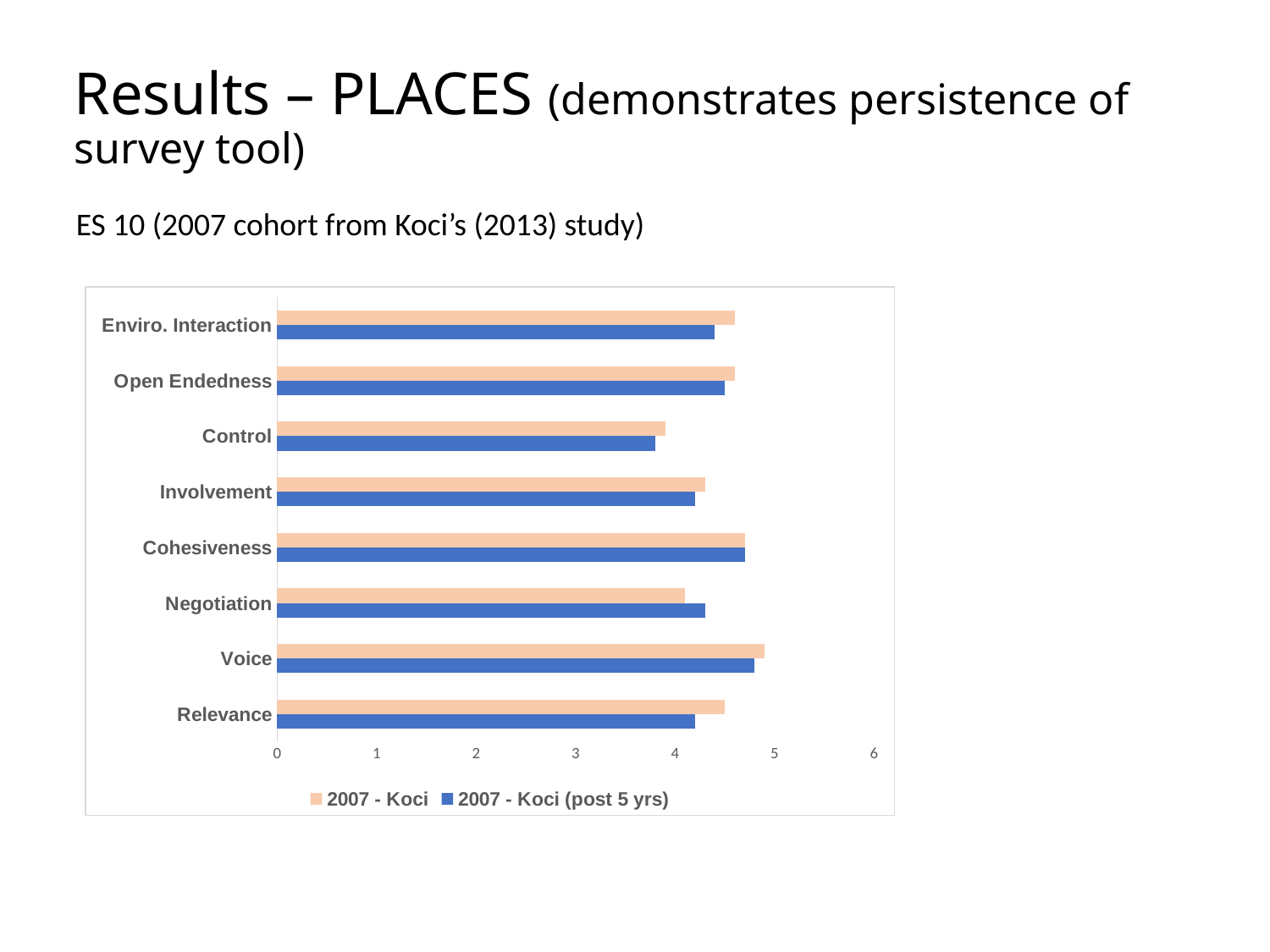
Which category has the highest value for the 2007 - Koci series? Voice For Negotiation, which series has the larger value: 2007 - Koci or 2007 - Koci (post 5 yrs)? 2007 - Koci (post 5 yrs) Is the 2007 - Koci value for Voice greater or less than 5? less Is the 2007 - Koci value for Control greater or less than 4? less How many series does the chart's legend list? 2 Which series is shown in blue in the chart's legend? 2007 - Koci (post 5 yrs) What kind of chart is shown on the slide? bar chart Is the 2007 - Koci (post 5 yrs) value for Relevance greater or less than 4? greater For Relevance, which series has the larger value: 2007 - Koci or 2007 - Koci (post 5 yrs)? 2007 - Koci How many categories are plotted on the chart? 8 Which category has the lowest value for the 2007 - Koci series? Control Which category has the lowest value for the 2007 - Koci (post 5 yrs) series? Control